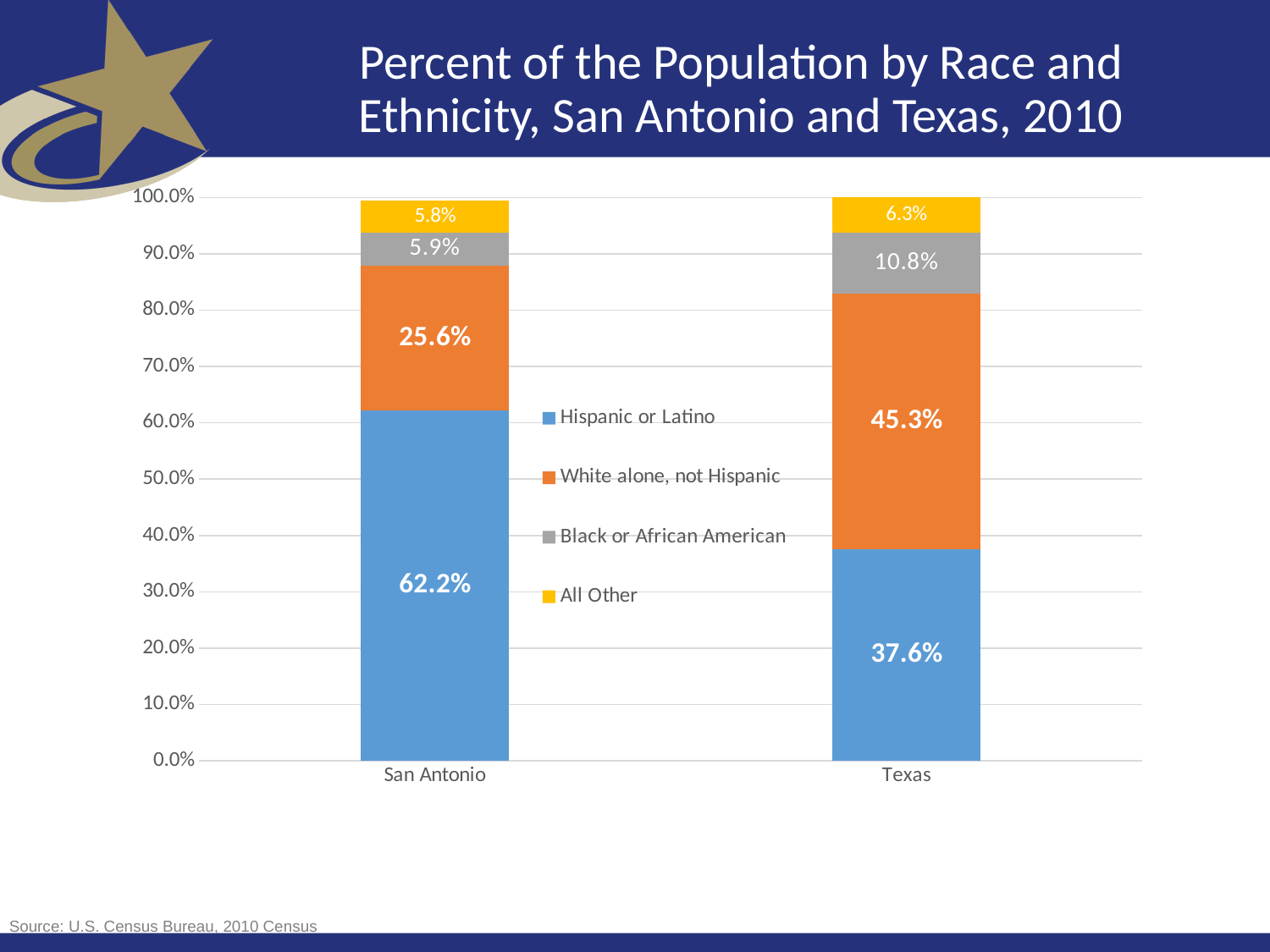
What is the difference between the White alone, not Hispanic share in Texas and in San Antonio? 19.7 percentage points What type of chart is shown on the slide? Stacked bar chart How many series does the legend list? 4 What percentage of Texas's population is White alone, not Hispanic? 45.3% What percentage of San Antonio's population is Hispanic or Latino? 62.2% Which group has the smallest share of the population in San Antonio? All Other What is the value for All Other in San Antonio? 5.8% How many categories are shown on the x axis? 2 Which group has the largest share of the population in Texas? White alone, not Hispanic Which is larger: the Black or African American share in Texas or in San Antonio? Texas How many percentage points higher is the Hispanic or Latino share in San Antonio than in Texas? 24.6 What is the value for Black or African American in Texas? 10.8%